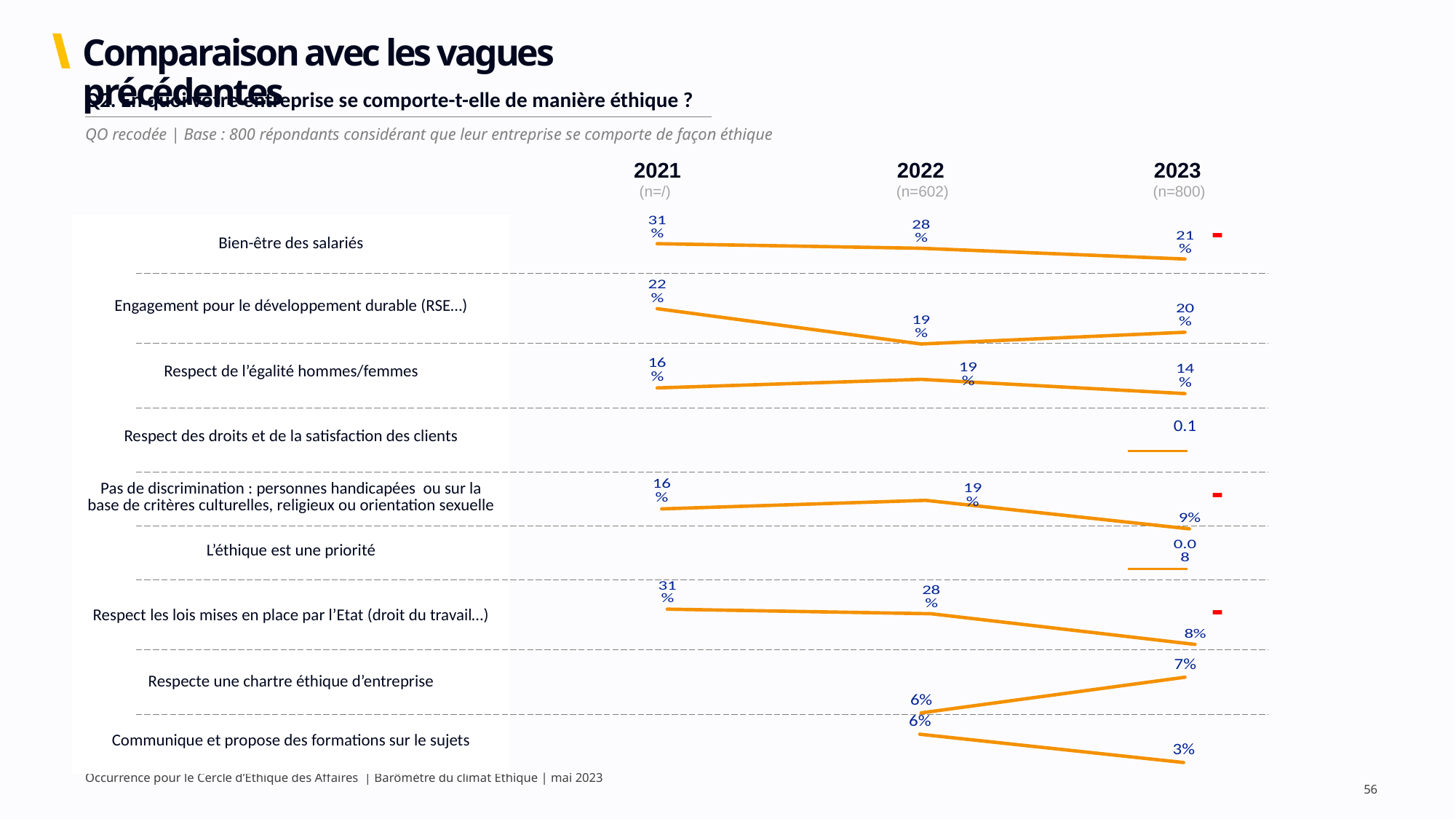
In the 'Respect de l'égalité hommes/femmes' chart, which year has the highest value? 2022 What kind of chart is used for each row on the slide? line chart In the 'Pas de discrimination' chart, which year has the lowest value? 2023 In the 'Bien-être des salariés' chart, what is the value for 2023? 21% In the 'Respect les lois mises en place par l'Etat (droit du travail…)' chart, what is the value for 2023? 8% In the 'Bien-être des salariés' chart, what is the difference between the 2021 and 2023 values? 10% In the 'Engagement pour le développement durable (RSE…)' chart, what is the value for 2022? 19% In the 'Respecte une chartre éthique d'entreprise' chart, which is larger, the 2022 value or the 2023 value? 2023 In the 'Pas de discrimination' chart, what is the difference between the 2022 and 2023 values? 10% How many years (data points) are plotted in the 'Bien-être des salariés' chart? 3 In the 'Communique et propose des formations sur le sujets' chart, what is the value for 2023? 3% In the 'Respect les lois mises en place par l'Etat (droit du travail…)' chart, do the values rise or fall from 2021 to 2023? fall